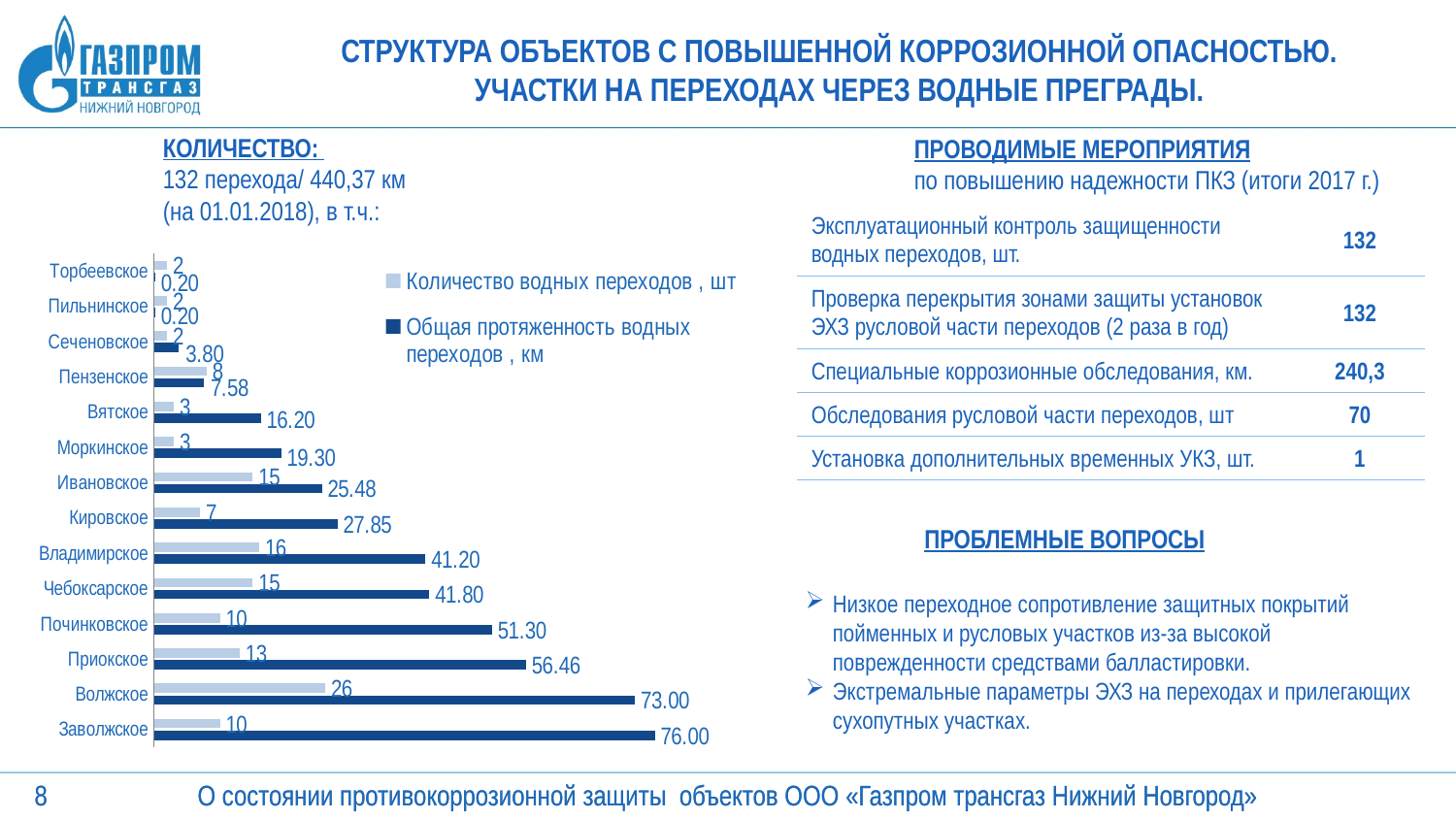
Which category has the lowest total length of water crossings (км), Пензенское or Сеченовское? Сеченовское What is the total length of water crossings (Общая протяженность водных переходов, км) for Заволжское? 76.00 What type of chart is shown on the slide? bar chart How many categories (branches) are shown on the chart? 14 Which has a larger number of water crossings (шт): Владимирское or Чебоксарское? Владимирское How many series does the chart legend list? 2 What is the total length of water crossings (км) for Приокское? 56.46 What is the difference in total length of water crossings (км) between Заволжское and Волжское? 3.00 What is the difference in the number of water crossings (шт) between Волжское and Приокское? 13 Which category has the highest number of water crossings (шт)? Волжское What is the number of water crossings (Количество водных переходов, шт) for Волжское? 26 Which category has the highest total length of water crossings (км)? Заволжское